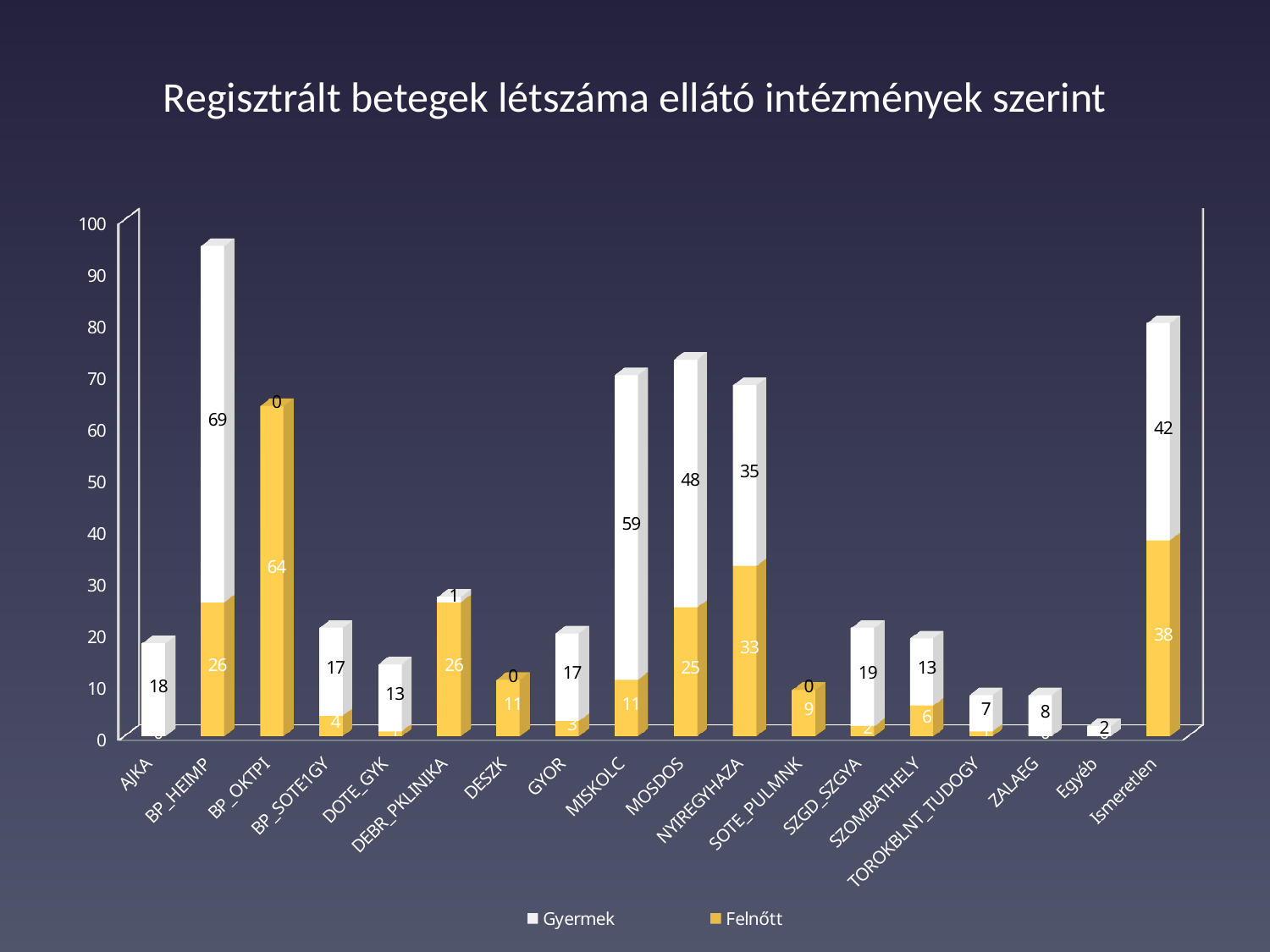
What is the total of the stacked bar for Ismeretlen? 80 What is the Felnőtt value for Ismeretlen? 38 What is the Gyermek value for MISKOLC? 59 What is the difference between the Gyermek values for BP_HEIMP and Ismeretlen? 27 How many series does the legend list? 2 How many categories are shown on the x axis? 18 What is the Felnőtt value for BP_OKTPI? 64 What is the total of the stacked bar for BP_HEIMP? 95 Which is larger, the Gyermek value for MISKOLC or for MOSDOS? MISKOLC Which category has the highest Gyermek value? BP_HEIMP Which category has the highest Felnőtt value? BP_OKTPI What is the Gyermek value for BP_HEIMP? 69